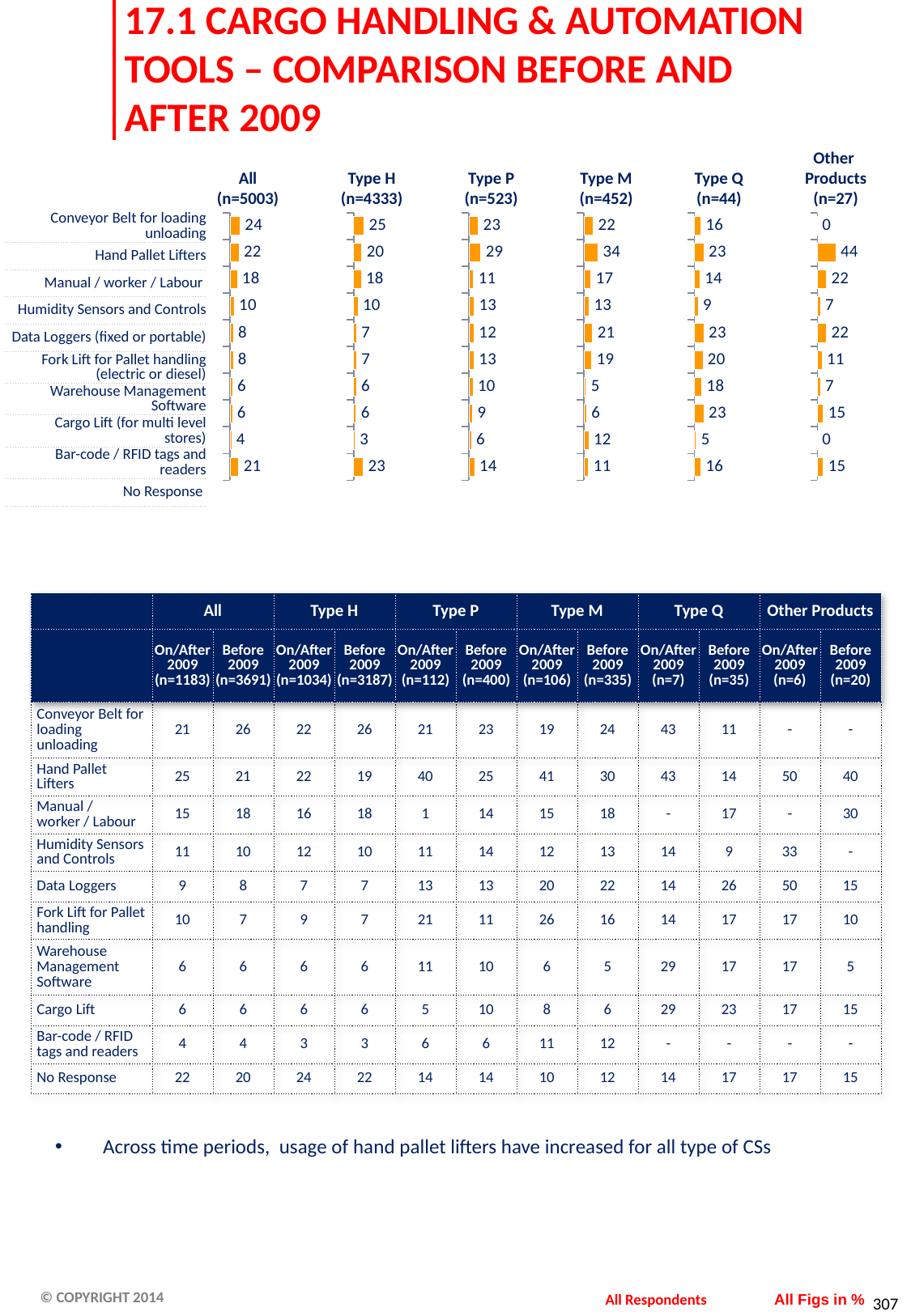
In the 'All (n=5003)' chart, what is the difference between the values for Hand Pallet Lifters and Manual / worker / Labour? 4 What is the difference between the Conveyor Belt for loading unloading values in the 'Type H (n=4333)' chart and the 'Type P (n=523)' chart? 2 What kind of chart is the 'All (n=5003)' chart? Bar chart In the 'Type M (n=452)' chart, which category has the highest value? Hand Pallet Lifters In the 'Type H (n=4333)' chart, what is the value for Fork Lift for Pallet handling (electric or diesel)? 7 In the 'All (n=5003)' chart, what is the value for Conveyor Belt for loading unloading? 24 In the 'Other Products (n=27)' chart, which category has the highest value? Hand Pallet Lifters Which chart shows a larger value for Data Loggers (fixed or portable): 'Type M (n=452)' or 'Type Q (n=44)'? Type Q (n=44) In the 'Type M (n=452)' chart, what is the value for Hand Pallet Lifters? 34 In the 'Type Q (n=44)' chart, what is the value for Humidity Sensors and Controls? 9 In the 'Type P (n=523)' chart, what is the value for Manual / worker / Labour? 11 How many small bar charts are shown in the top section of the slide? 6